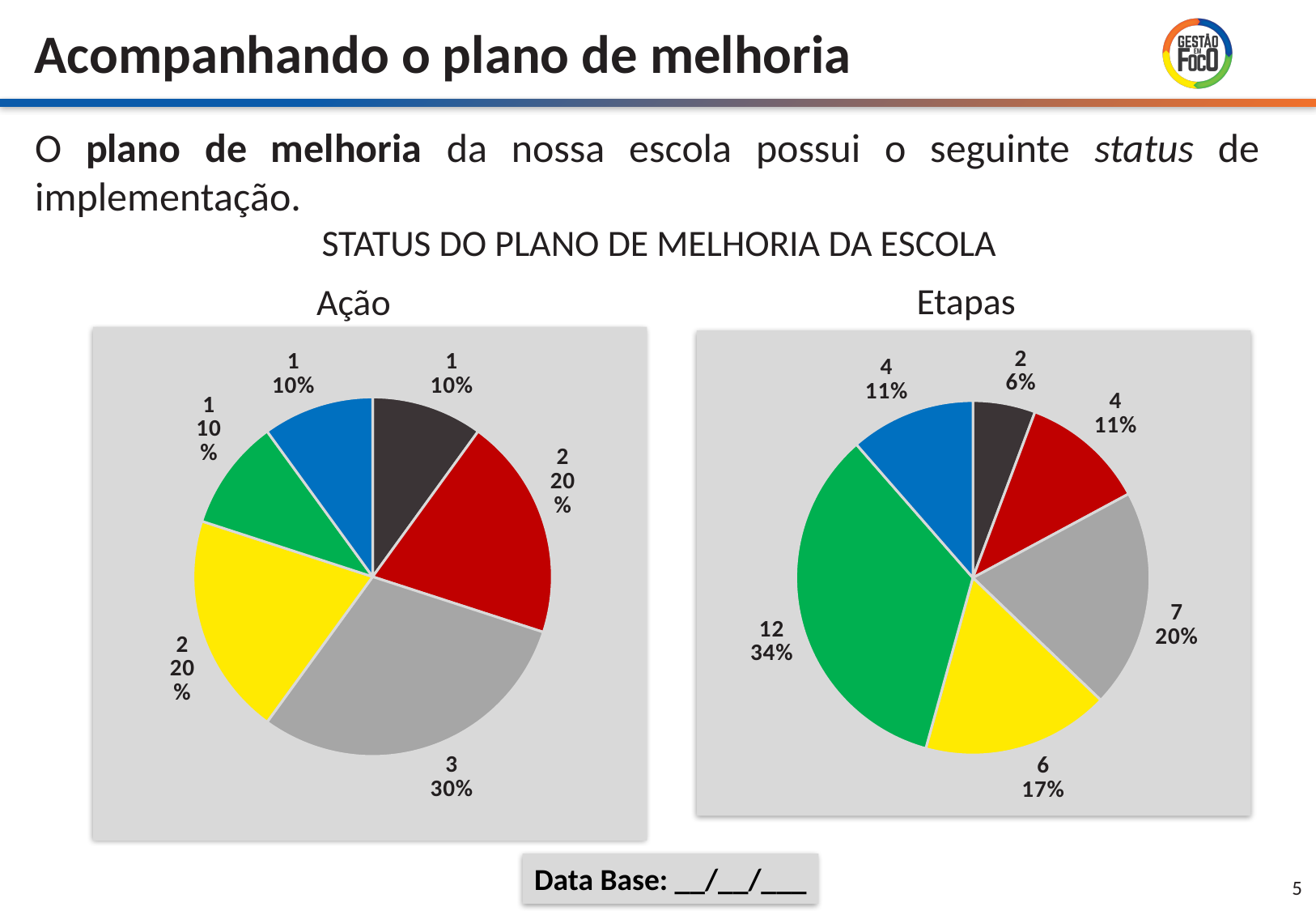
What is the total of the values shown on all slices of the "Etapas" chart? 35 How many slices does the "Etapas" pie chart have? 6 In the "Etapas" chart, which slice is larger: the grey slice or the yellow slice? grey slice What is the total of the values shown on all slices of the "Ação" chart? 10 In the "Etapas" chart, what percentage does the smallest slice (dark grey) represent? 6% In the "Etapas" chart, what is the difference between the value of the green slice and the value of the grey slice? 5 What type of chart is used for the "Ação" chart? pie chart In the "Ação" chart, what percentage does the largest slice (grey) represent? 30% In the "Etapas" chart, what is the value shown on the largest slice (green)? 12 In the "Ação" chart, what value is shown on the red slice? 2 In the "Etapas" chart, what percentage is shown on the yellow slice? 17% What is the overall title shown above the two pie charts? STATUS DO PLANO DE MELHORIA DA ESCOLA